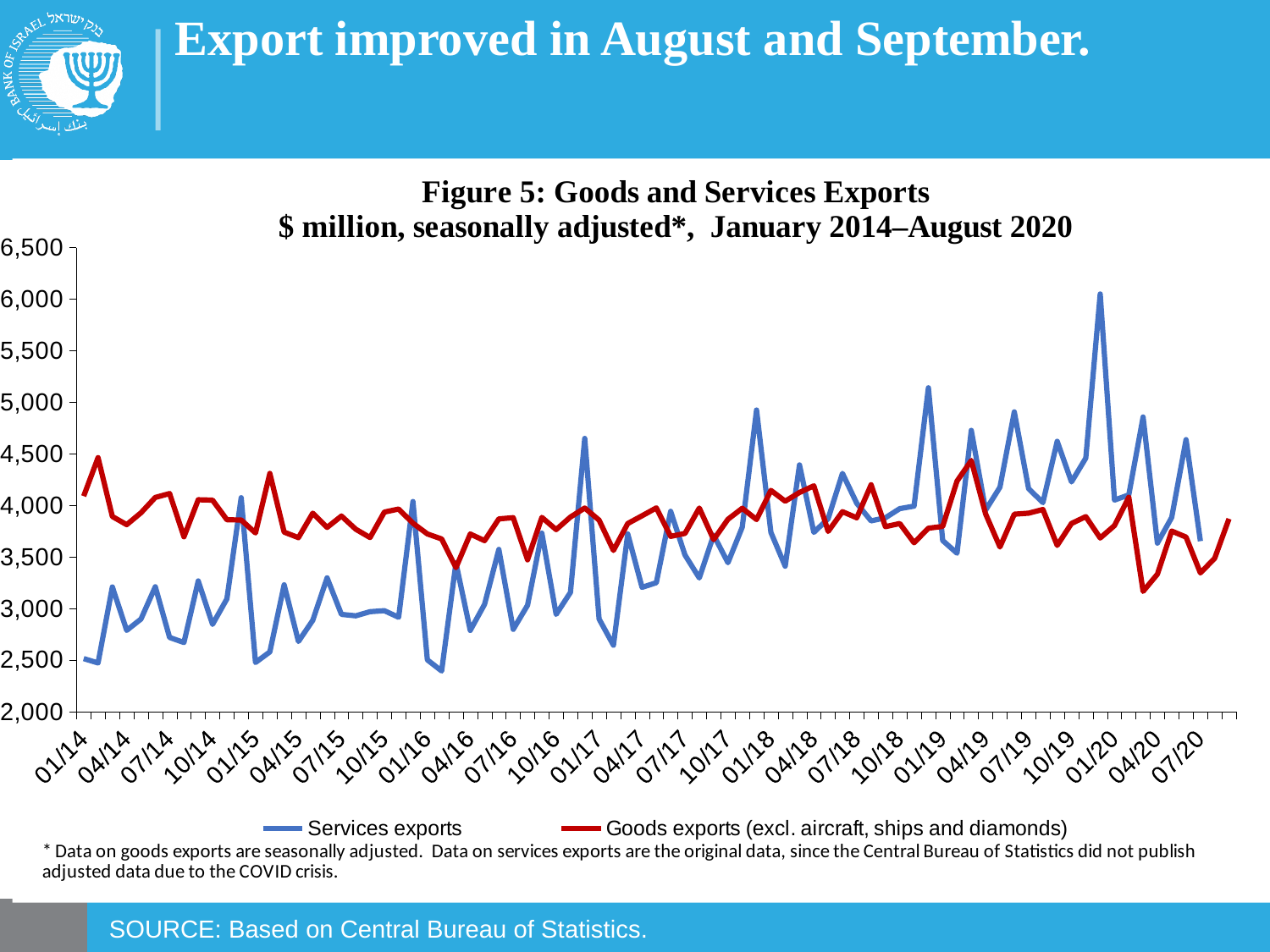
Is the value for Services exports at 01/14 greater or less than 3,000? less What colour is the Services exports line in Figure 5? blue Which series reaches the highest value anywhere on the chart? Services exports Overall, do Services exports rise or fall from 01/14 to 01/20? rise What kind of chart is shown in Figure 5? line chart At 01/20, which series has the higher value, Services exports or Goods exports? Services exports What are the two series named in the legend of Figure 5? Services exports; Goods exports (excl. aircraft, ships and diamonds) How many series does the legend of Figure 5 list? 2 Is the value for Goods exports at 04/15 greater or less than 4,000? less Is the peak value of Services exports around 01/20 greater or less than 5,500? greater At 01/14, which series has the higher value, Services exports or Goods exports? Goods exports